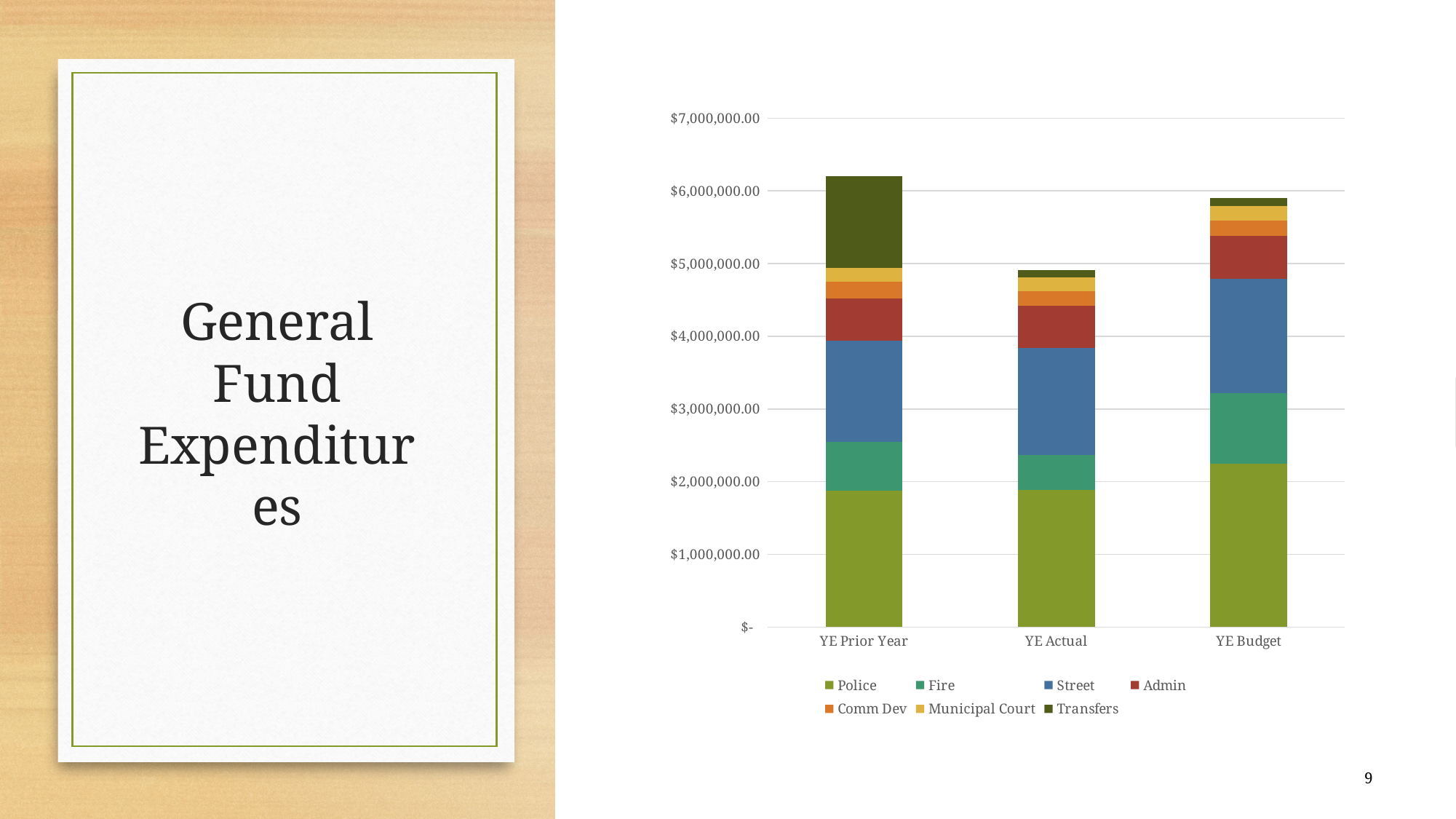
What kind of chart is shown on the slide? Stacked bar chart Is the total of the YE Actual bar greater or less than $5,000,000.00? less Is the Police value for YE Budget greater or less than $2,000,000.00? greater Is the total of the YE Prior Year bar greater or less than $6,000,000.00? greater Which category has the shortest stacked bar? YE Actual How many categories are shown along the x axis of the chart? 3 Which stacked bar is taller, YE Prior Year or YE Actual? YE Prior Year In which category is the Transfers segment the largest? YE Prior Year How many series does the chart's legend list? 7 Which category has the tallest stacked bar? YE Prior Year What is the title of the slide that accompanies the chart? General Fund Expenditures